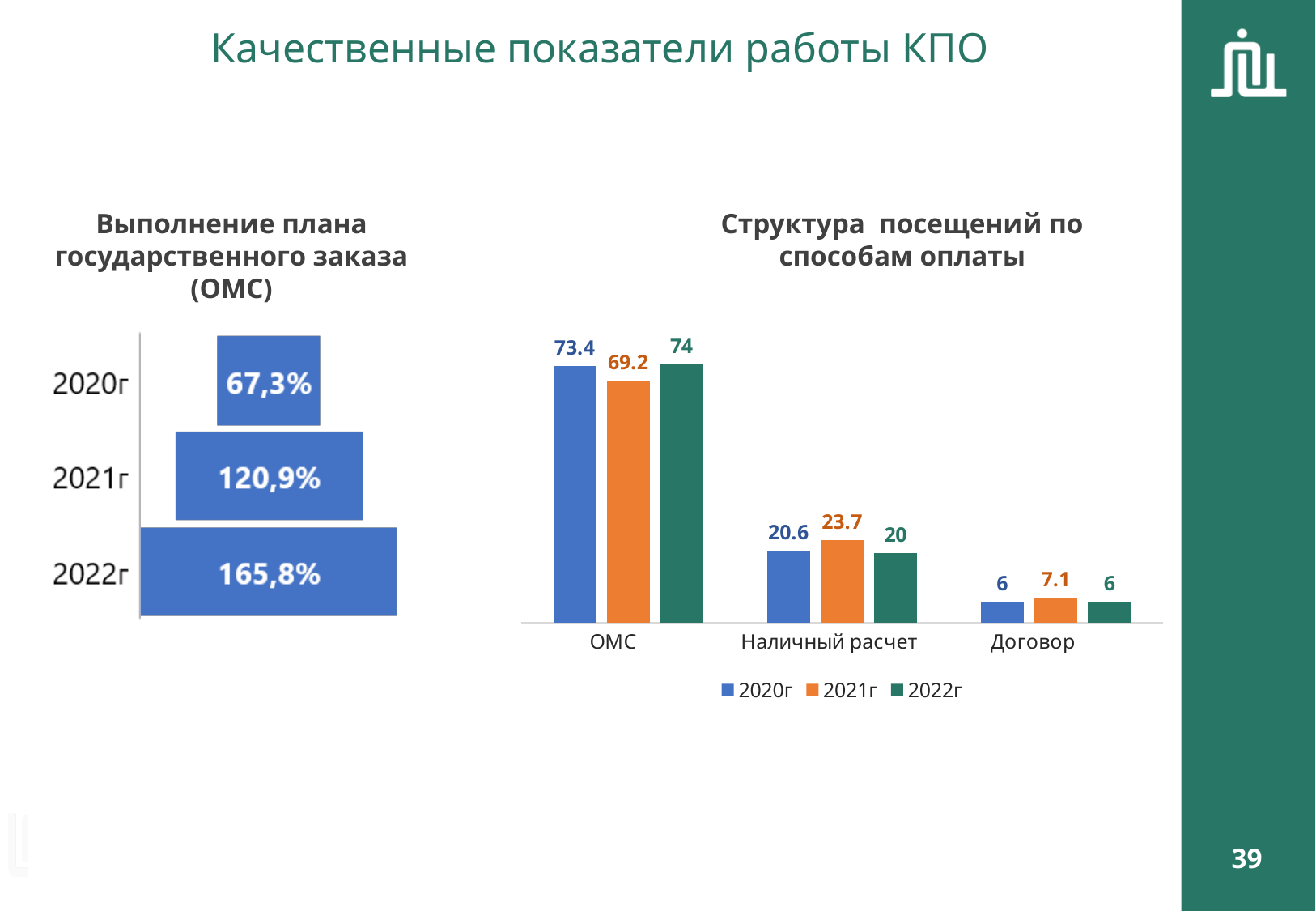
In the chart 'Структура посещений по способам оплаты', what is the value for ОМС in 2022г? 74 In the chart 'Структура посещений по способам оплаты', which is larger for Договор: the 2021г value or the 2022г value? 2021г In the chart 'Выполнение плана государственного заказа (ОМС)', which year has the lowest value? 2020г In the chart 'Выполнение плана государственного заказа (ОМС)', what is the value for 2021г? 120,9% In the chart 'Выполнение плана государственного заказа (ОМС)', do the values rise or fall from 2020г to 2022г? rise In the chart 'Структура посещений по способам оплаты', what is the difference between the 2020г and 2021г values for ОМС? 4.2 In the chart 'Выполнение плана государственного заказа (ОМС)', which year has the highest value? 2022г What kind of chart is 'Выполнение плана государственного заказа (ОМС)'? bar chart In the chart 'Структура посещений по способам оплаты', which category has the lowest values across all years? Договор In the chart 'Структура посещений по способам оплаты', how many series does the legend list? 3 In the chart 'Структура посещений по способам оплаты', what is the value for Наличный расчет in 2021г? 23.7 In the chart 'Выполнение плана государственного заказа (ОМС)', how many years are shown? 3